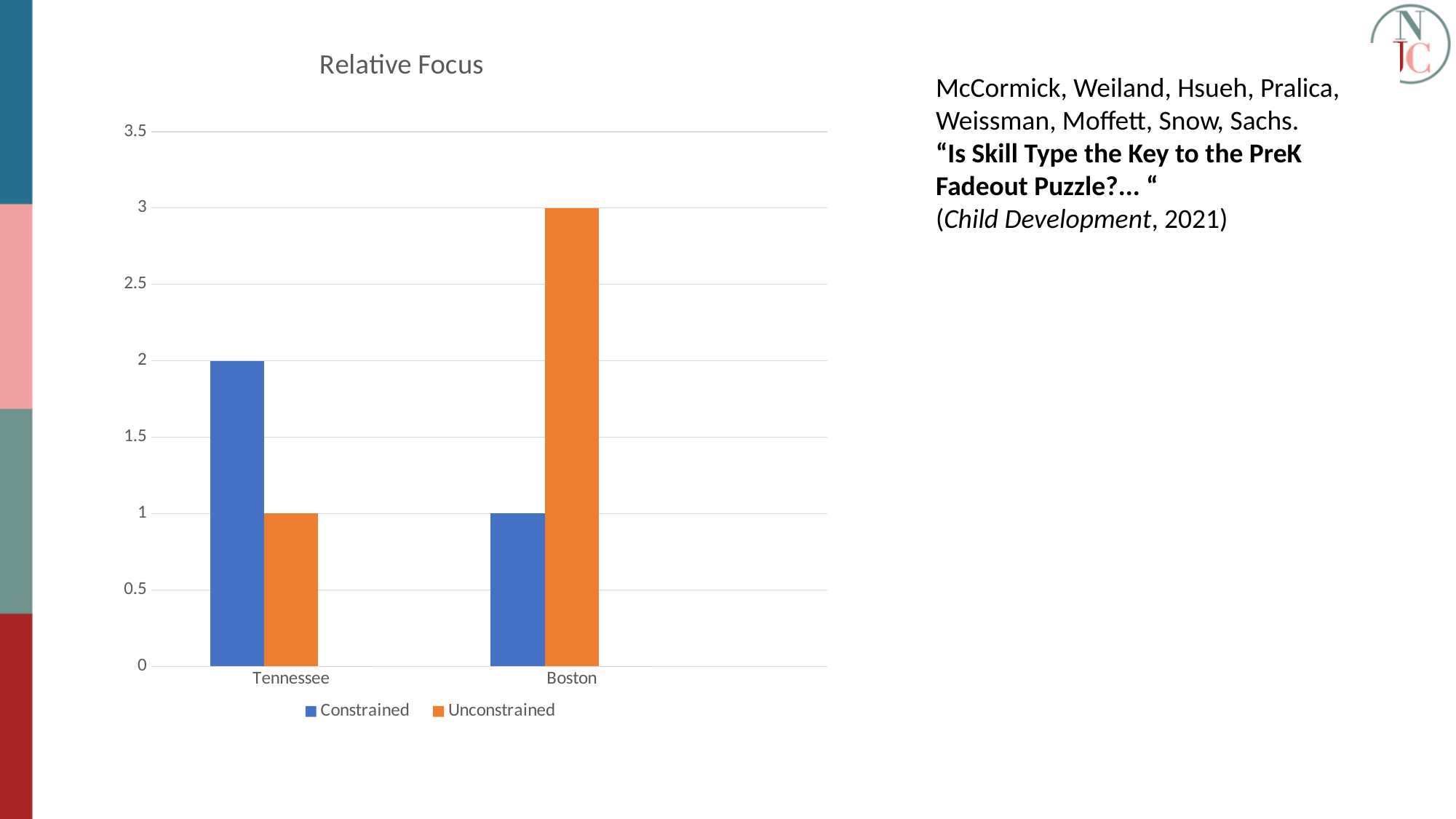
What is the Constrained value for Tennessee? 2 Which category has the highest Unconstrained value? Boston What is the Unconstrained value for Boston? 3 Which category has the lowest Constrained value? Boston How many categories are shown on the x axis of the chart? 2 How many series does the chart legend list? 2 What is the Constrained value for Boston? 1 What kind of chart is shown on the slide? Bar chart What is the difference between the Unconstrained value for Boston and the Constrained value for Boston? 2 What is the title of the chart? Relative Focus What is the Unconstrained value for Tennessee? 1 Which is larger for Tennessee, the Constrained value or the Unconstrained value? Constrained